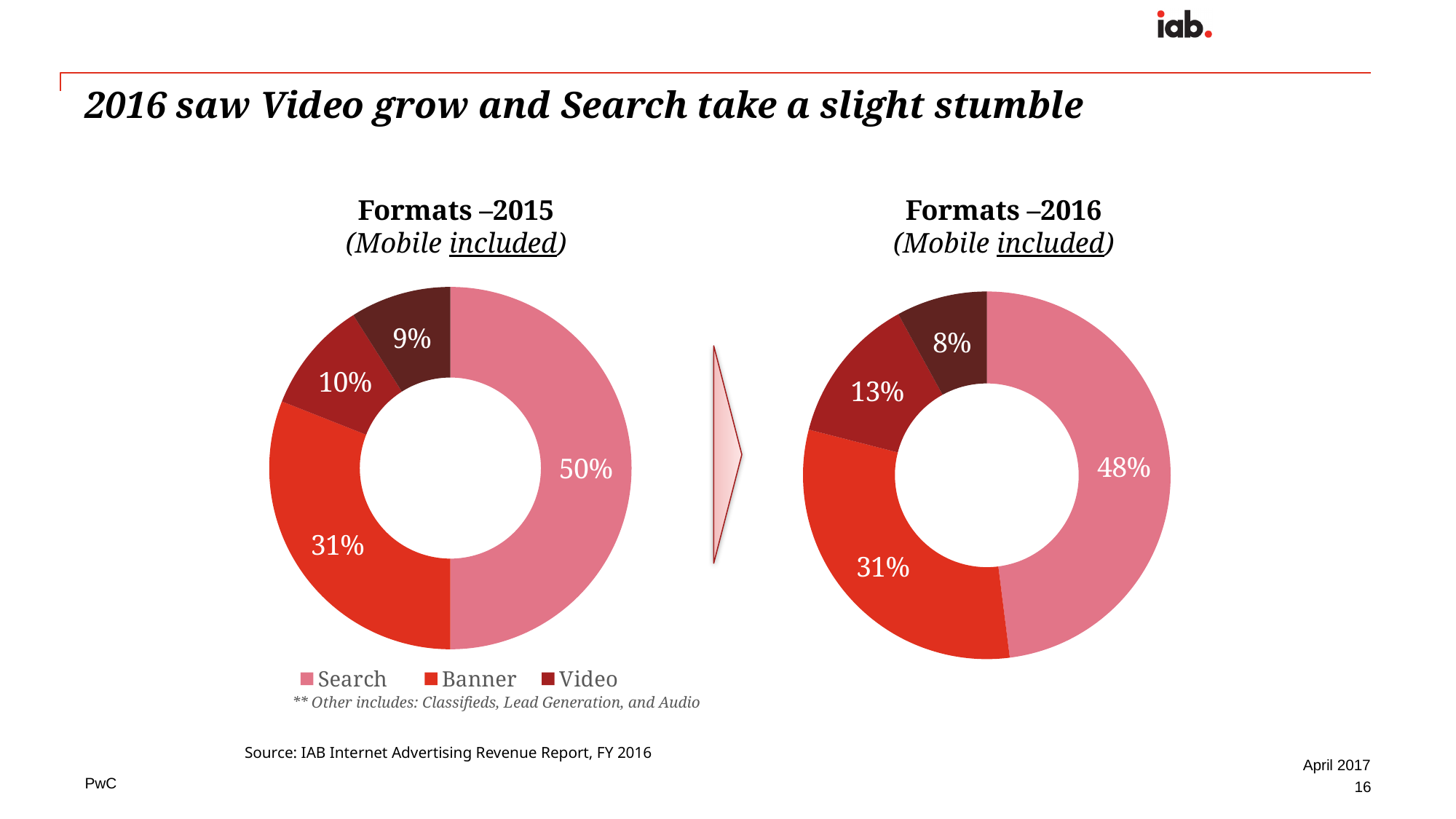
In the Formats –2016 chart, what is the difference between the Search and Banner shares? 17 percentage points In the Formats –2015 chart, what share does Video have? 10% What kind of charts are shown on the slide? Pie (donut) charts By how many percentage points did Search's share fall from the Formats –2015 chart to the Formats –2016 chart? 2 percentage points In the Formats –2015 chart, what share does Search have? 50% How many slices does the Formats –2016 chart have? 4 Is Video's share larger in the Formats –2015 chart or the Formats –2016 chart? Formats –2016 Is Banner's share in the Formats –2016 chart larger, smaller, or the same as in the Formats –2015 chart? The same In the Formats –2016 chart, what share does Video have? 13% In the Formats –2016 chart, what share does Banner have? 31% How many entries does the legend list? 3 In the Formats –2016 chart, which format has the largest share? Search